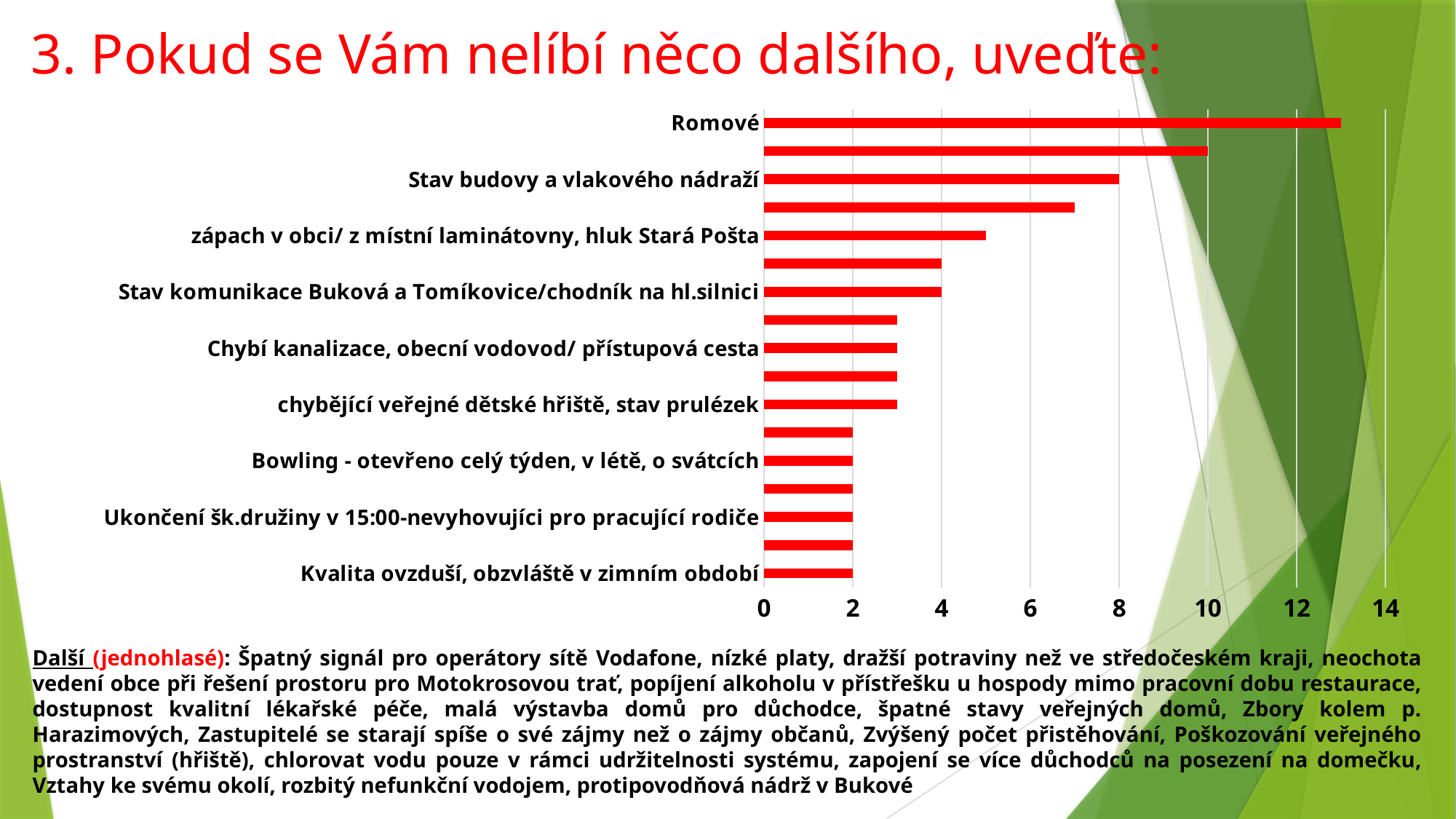
What kind of chart is shown on the slide? bar chart Which is larger, the value for "Romové" or the value for "Stav budovy a vlakového nádraží"? Romové Is the value for "zápach v obci/ z místní laminátovny, hluk Stará Pošta" greater or less than 6? less What is the value for "Bowling - otevřeno celý týden, v létě, o svátcích"? 2 Which is larger, the value for "Stav komunikace Buková a Tomíkovice/chodník na hl.silnici" or the value for "Ukončení šk.družiny v 15:00-nevyhovujíci pro pracující rodiče"? Stav komunikace Buková a Tomíkovice/chodník na hl.silnici Is the value for "Romové" greater or less than 12? greater Is the value for "Chybí kanalizace, obecní vodovod/ přístupová cesta" greater or less than 2? greater What is the value for "Kvalita ovzduší, obzvláště v zimním období"? 2 Which category has the highest value in the chart? Romové What colour are the bars in the chart? red What is the value for "Stav budovy a vlakového nádraží"? 8 What is the value for "Stav komunikace Buková a Tomíkovice/chodník na hl.silnici"? 4